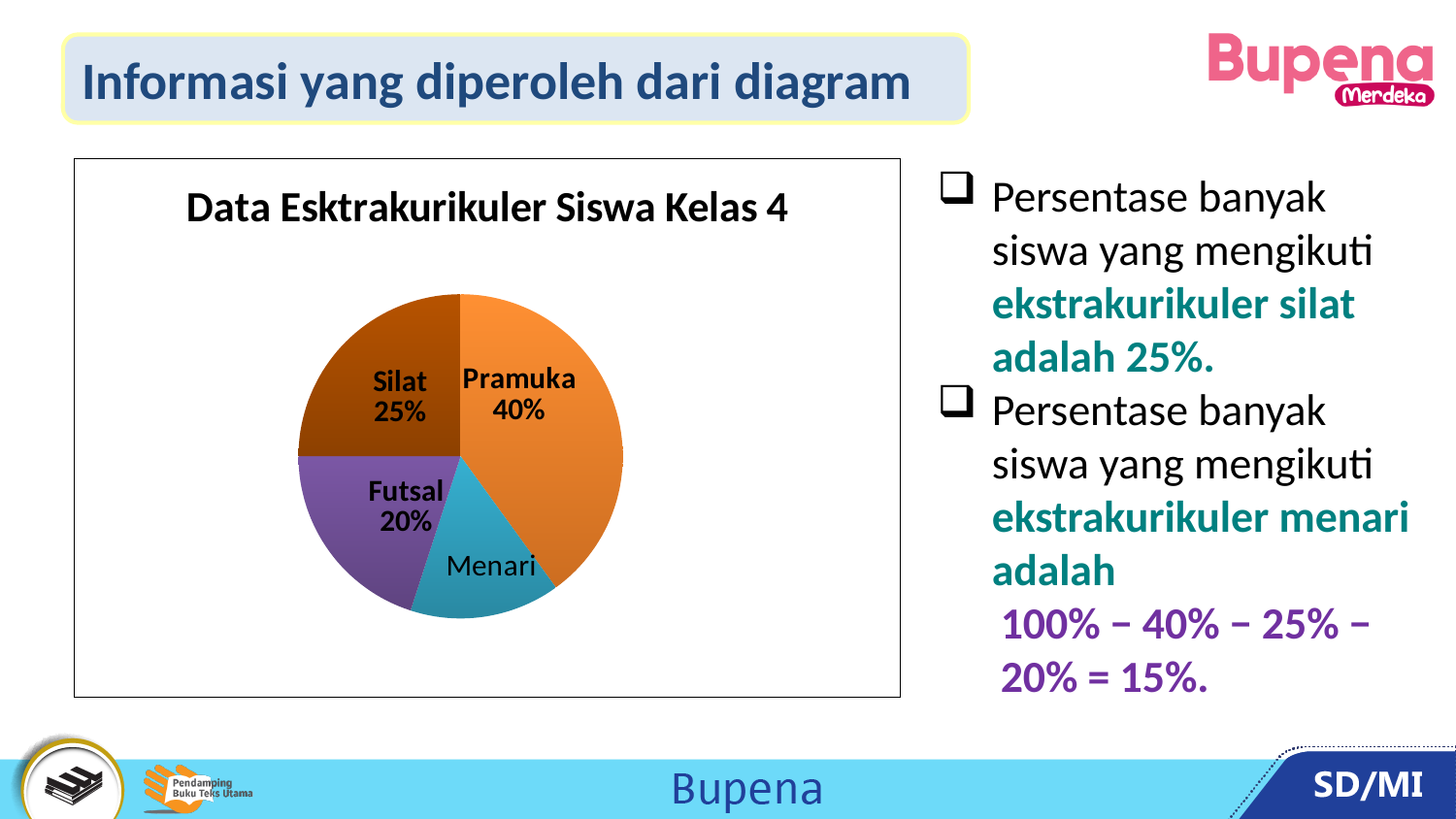
Which is larger, the share for Silat or the share for Futsal? Silat What percentage of students take Futsal? 20% Which extracurricular activity has the smallest share of the pie? Menari According to the slide, what percentage of students take Menari? 15% What is the title of the chart? Data Esktrakurikuler Siswa Kelas 4 What type of chart is shown on the slide? pie chart What percentage of students take Pramuka? 40% What percentage of students take Silat? 25% How many slices does the pie chart have? 4 What is the difference between the Pramuka and Silat percentages? 15% What colour is the Pramuka slice? orange Which extracurricular activity has the largest share of the pie? Pramuka